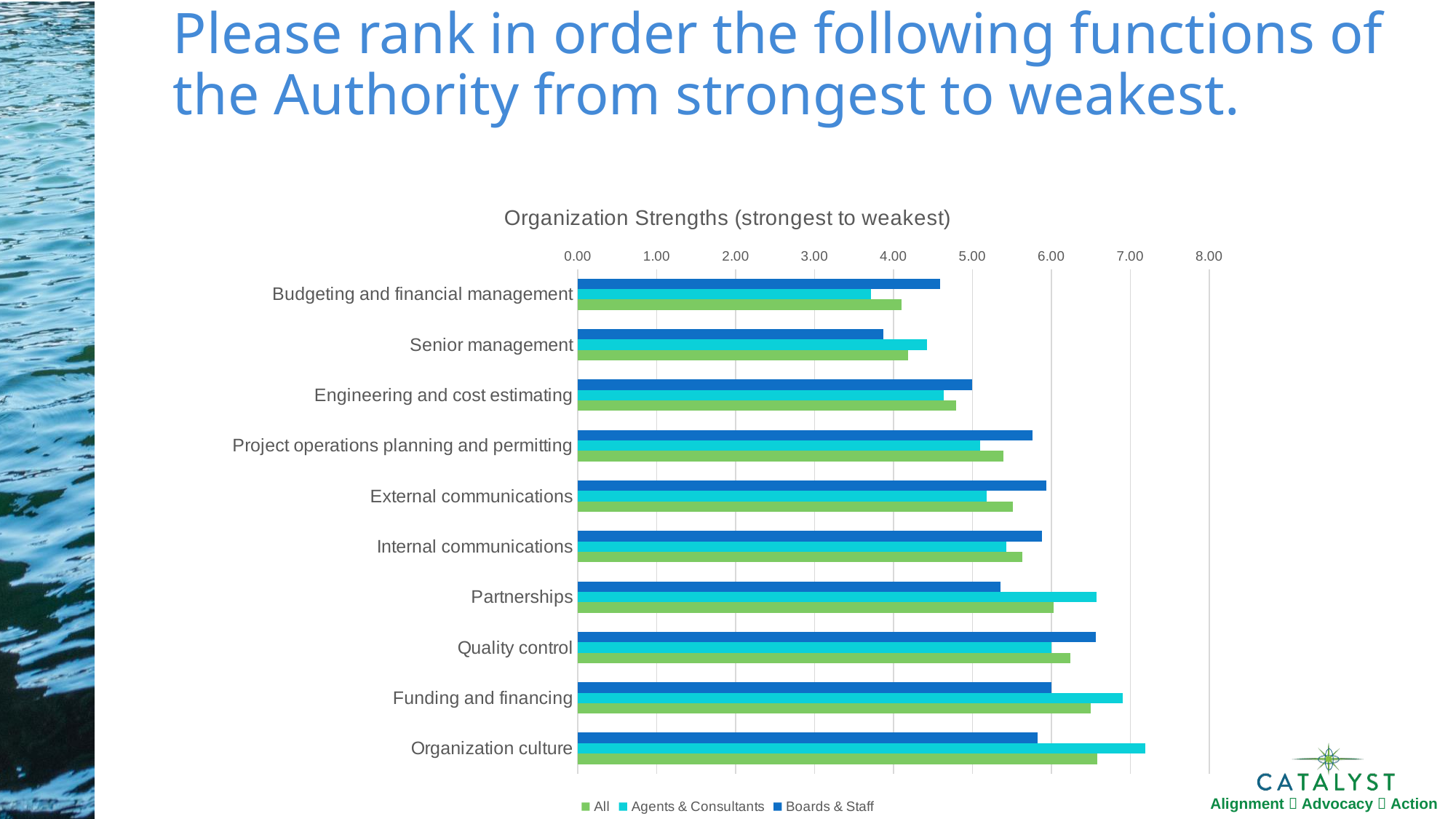
How many series does the legend list? 3 For Budgeting and financial management, which is larger: the Boards & Staff value or the Agents & Consultants value? Boards & Staff For Partnerships, which is larger: the Agents & Consultants value or the Boards & Staff value? Agents & Consultants Is the Agents & Consultants value for Organization culture greater or less than 7.00? greater Which function has the lowest value for the Agents & Consultants series? Budgeting and financial management What kind of chart is shown on the slide? bar chart How many functions (categories) are plotted on the chart? 10 Is the Agents & Consultants value for Budgeting and financial management greater or less than 4.00? less Is the Boards & Staff value for Budgeting and financial management greater or less than 5.00? less Which function has the highest value for the Agents & Consultants series? Organization culture Which function has the lowest value for the Boards & Staff series? Senior management What is the title of the chart? Organization Strengths (strongest to weakest)